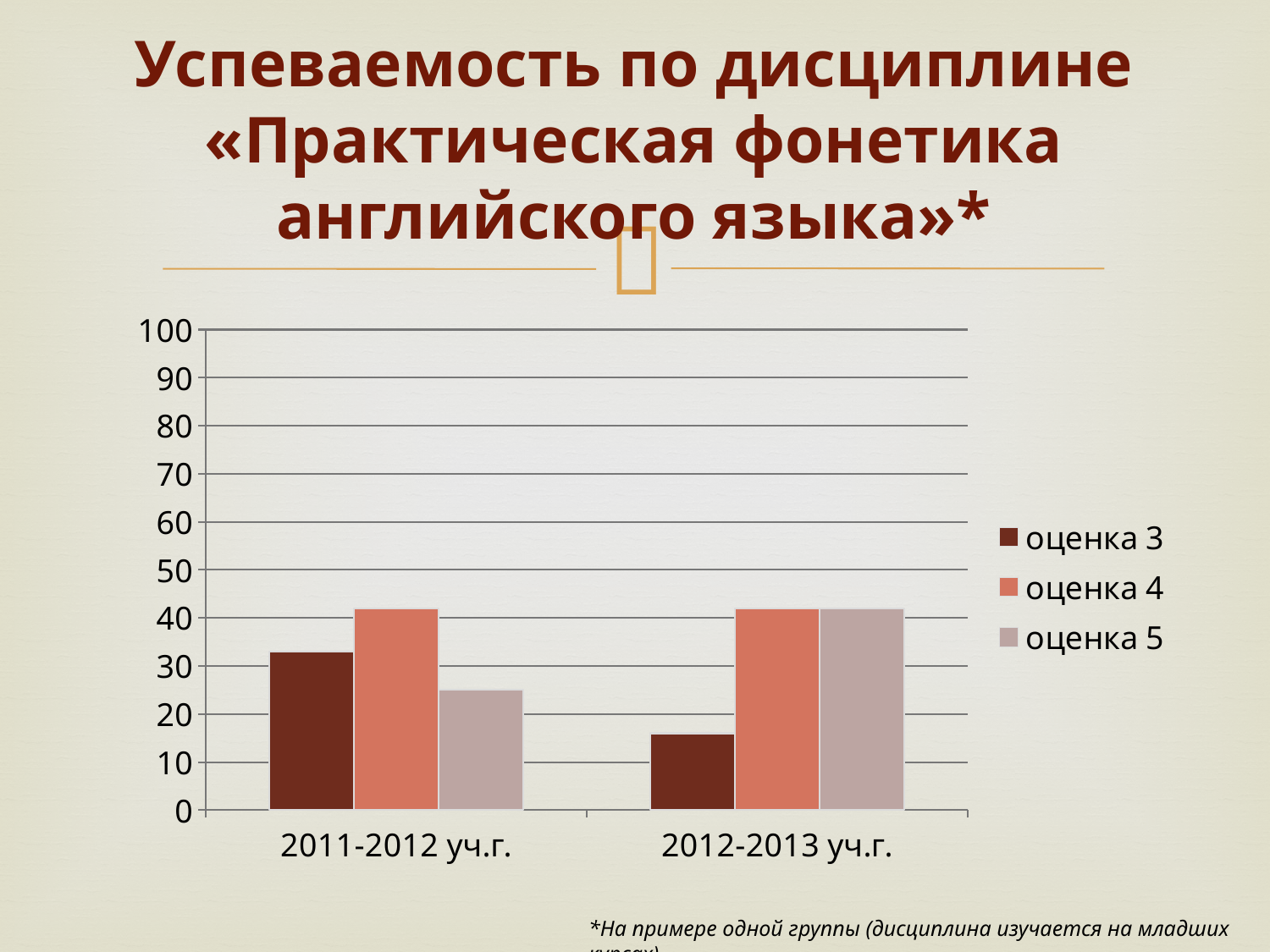
Is the value for оценка 3 in 2011-2012 уч.г. greater or less than 30? greater How many academic-year categories are shown on the x axis? 2 Which series has the lowest value in 2012-2013 уч.г.? оценка 3 Which legend entry is shown in the darkest brown colour? оценка 3 Does the value for оценка 5 rise or fall from 2011-2012 уч.г. to 2012-2013 уч.г.? rise What kind of chart is shown on the slide? bar chart Is the value for оценка 3 in 2012-2013 уч.г. greater or less than 20? less How many series does the legend list? 3 Which series has the highest value in 2011-2012 уч.г.? оценка 4 Is the value for оценка 5 in 2011-2012 уч.г. greater or less than 30? less Which is larger for оценка 3: the value in 2011-2012 уч.г. or in 2012-2013 уч.г.? 2011-2012 уч.г.